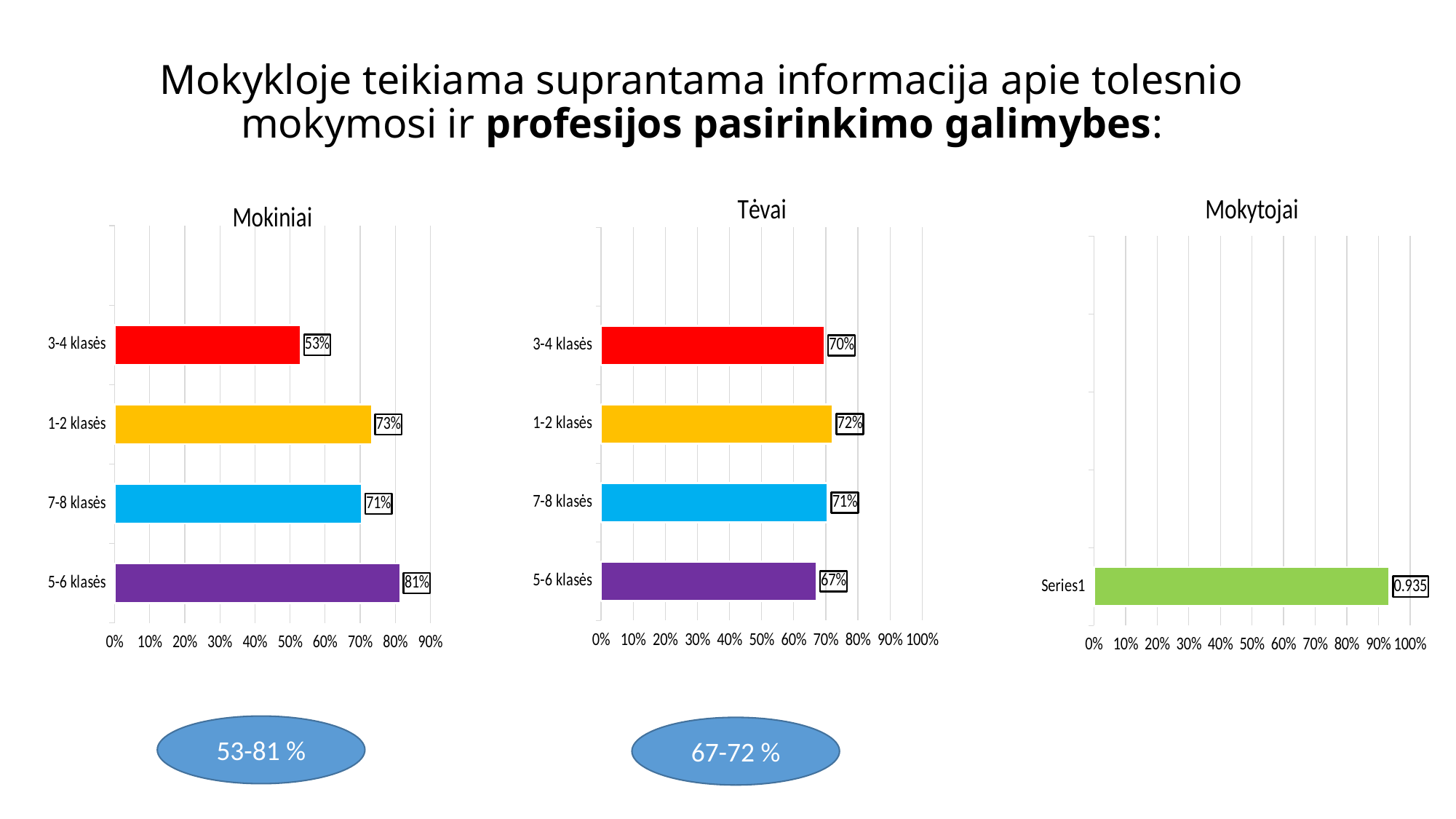
In the 'Mokiniai' chart, which category has the highest value? 5-6 klasės What type of chart is the 'Mokiniai' chart? Bar chart In the 'Mokytojai' chart, what is the value shown for Series1? 0.935 In the 'Tėvai' chart, what is the value for 1-2 klasės? 72% In the 'Tėvai' chart, which category has the lowest value? 5-6 klasės In the 'Mokiniai' chart, what is the difference between the values for 1-2 klasės and 7-8 klasės? 2% In the 'Mokiniai' chart, what is the value for 3-4 klasės? 53% How many categories are shown in the 'Tėvai' chart? 4 In the 'Mokiniai' chart, which category has the lowest value? 3-4 klasės What is the title of the chart on the right of the slide? Mokytojai In the 'Tėvai' chart, which is larger: the value for 3-4 klasės or the value for 5-6 klasės? 3-4 klasės In the 'Mokiniai' chart, what is the difference between the values for 5-6 klasės and 3-4 klasės? 28%